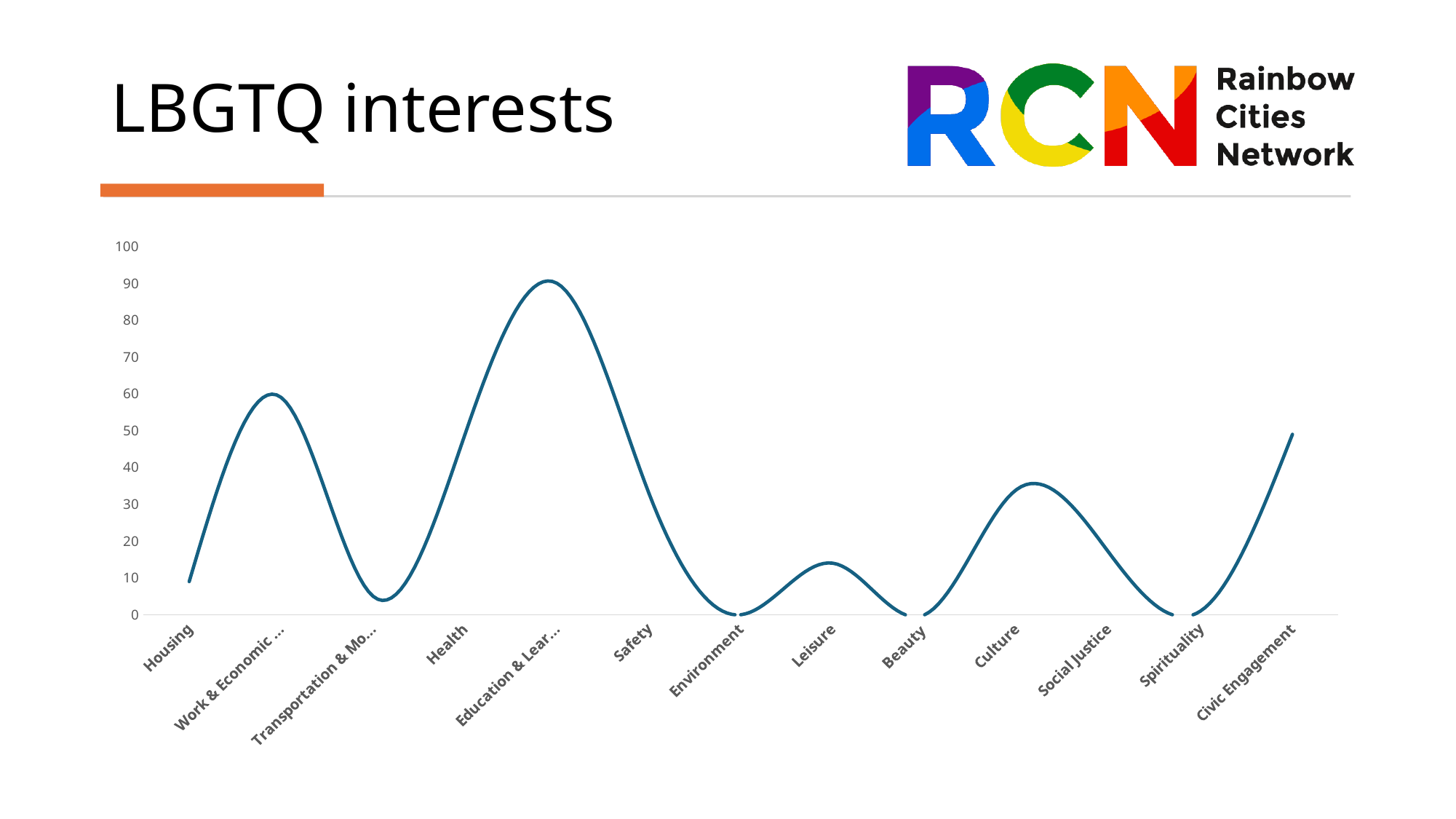
Is the value for Civic Engagement greater or less than 40? greater Is the value for Housing greater or less than 20? less Which is larger, the value for Civic Engagement or the value for Culture? Civic Engagement Is the value for Education & Lear... greater or less than 80? greater How many categories are plotted along the x axis? 13 What kind of chart is shown on the slide? line chart Which category has the highest value? Education & Lear... Which is larger, the value for Work & Economic ... or the value for Culture? Work & Economic ... What is the title of the slide containing the chart? LBGTQ interests